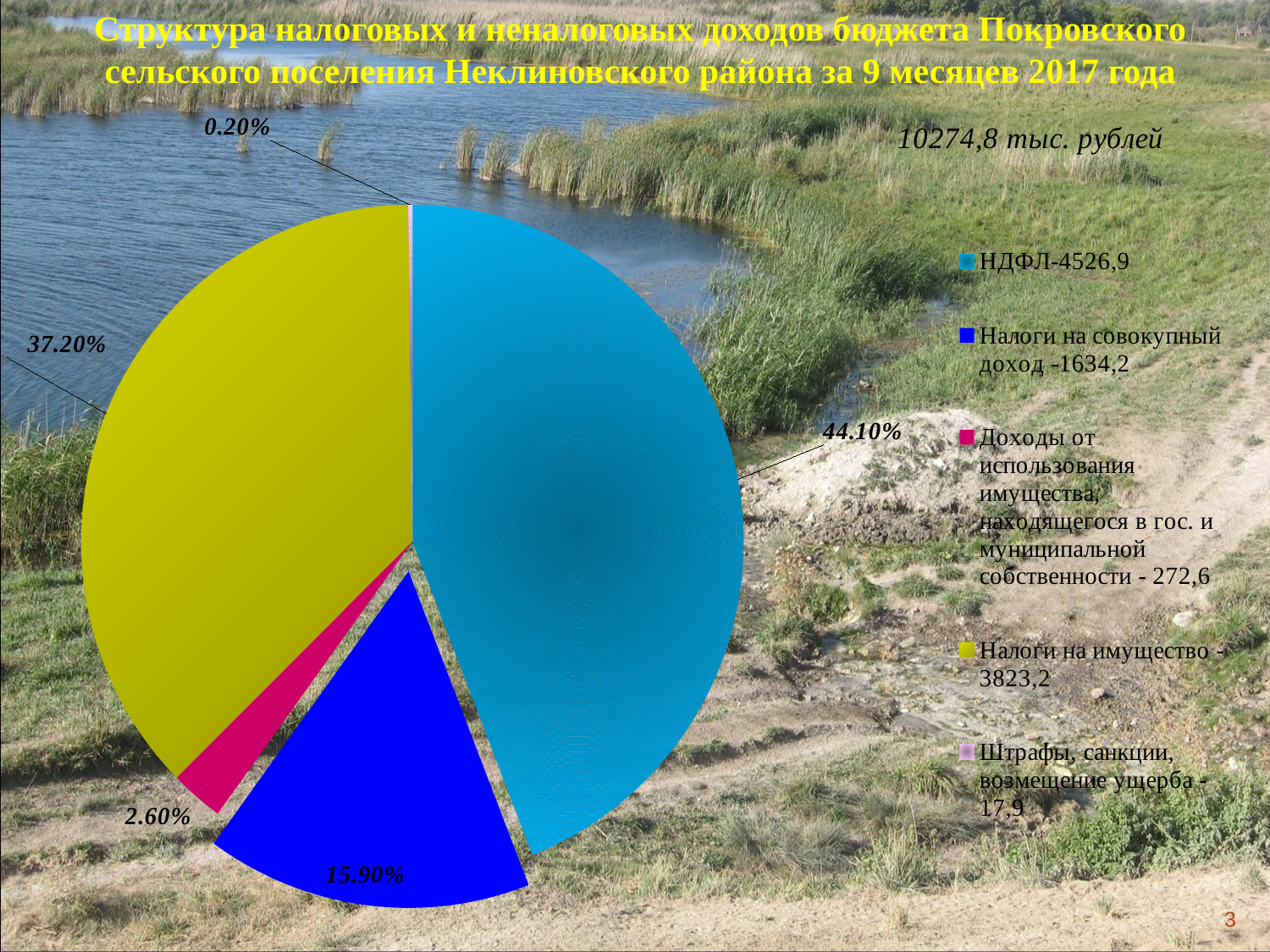
What percentage share does the Налоги на совокупный доход slice have? 15.90% What percentage share does the НДФЛ slice have? 44.10% How many entries does the legend list? 5 Which is larger: the share for Налоги на совокупный доход or the share for Доходы от использования имущества? Налоги на совокупный доход What percentage share does the Штрафы, санкции, возмещение ущерба slice have? 0.20% Which category has the largest share of the pie? НДФЛ Which category has the smallest share of the pie? Штрафы, санкции, возмещение ущерба What kind of chart is shown on the slide? pie chart How many slices does the pie chart have? 5 What value in тыс. рублей does the legend give for Налоги на имущество? 3823,2 What is the difference in percentage points between the НДФЛ share and the Налоги на имущество share? 6.90%